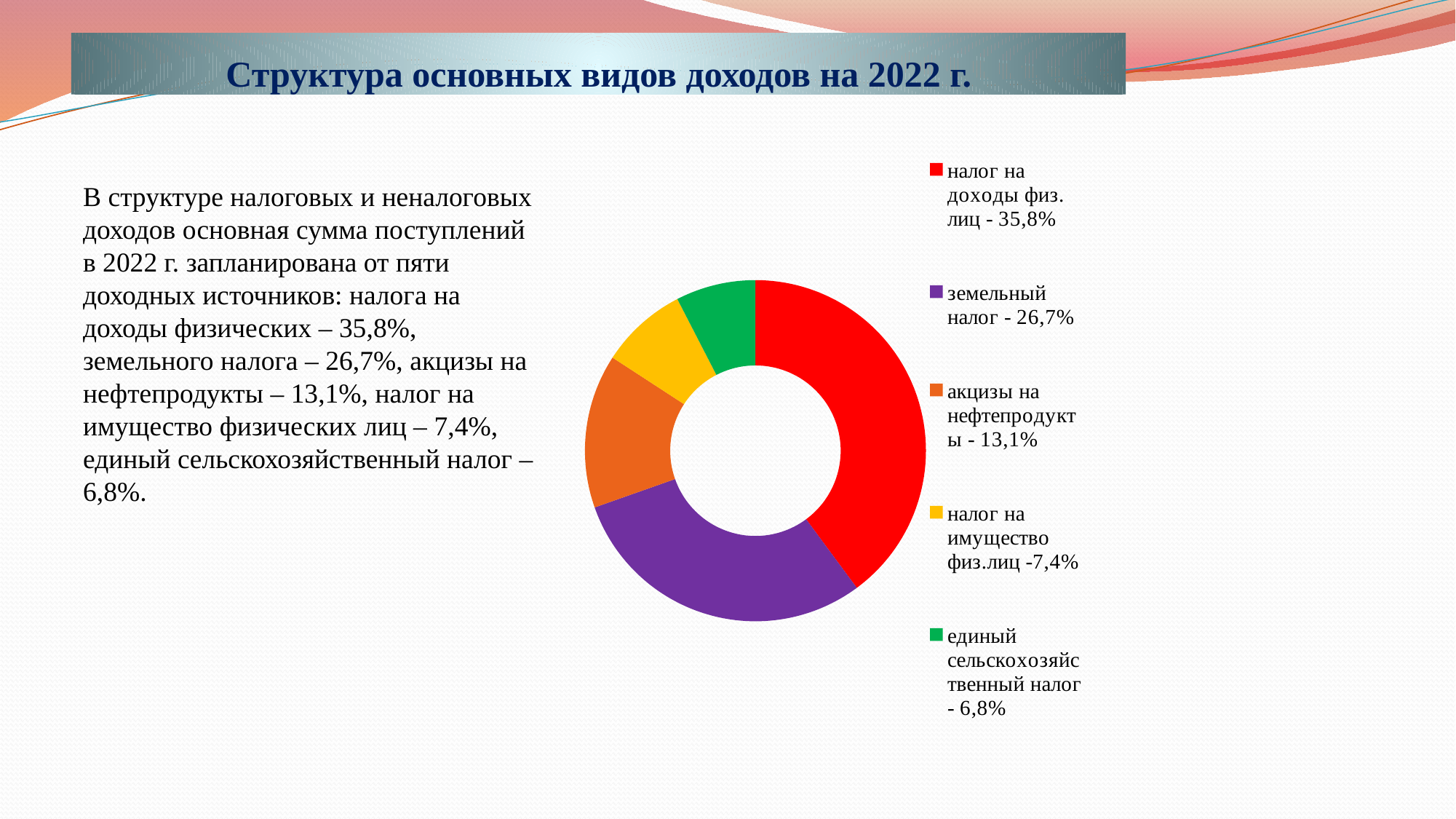
How many categories are shown in the chart? 5 Which is larger: акцизы на нефтепродукты or налог на имущество физ.лиц? акцизы на нефтепродукты What colour represents земельный налог in the chart? purple Which category has the smallest share in the chart? единый сельскохозяйственный налог What share does налог на имущество физ.лиц have in the chart? 7,4% What share does налог на доходы физ. лиц have in the chart? 35,8% What kind of chart is shown on the slide? doughnut chart What share does единый сельскохозяйственный налог have in the chart? 6,8% Which category has the largest share in the chart? налог на доходы физ. лиц What is the difference in percentage points between налог на доходы физ. лиц and земельный налог? 9,1 What share does акцизы на нефтепродукты have in the chart? 13,1% What share does земельный налог have in the chart? 26,7%